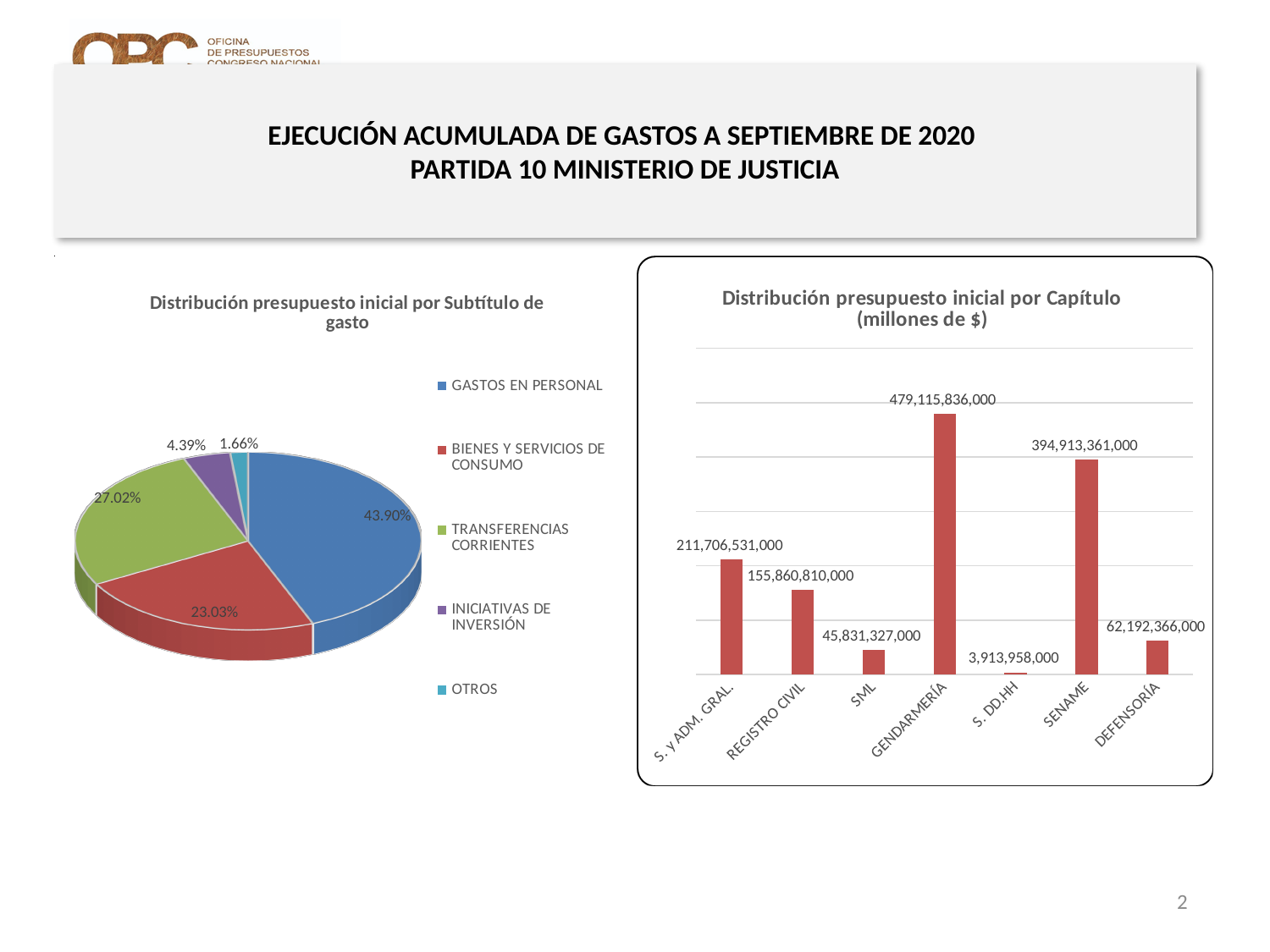
In the pie chart 'Distribución presupuesto inicial por Subtítulo de gasto', which category has the smallest slice? OTROS How many categories are shown in the chart 'Distribución presupuesto inicial por Capítulo (millones de $)'? 7 What kind of chart is 'Distribución presupuesto inicial por Capítulo (millones de $)'? Bar chart In the chart 'Distribución presupuesto inicial por Capítulo (millones de $)', what is the value for REGISTRO CIVIL? 155,860,810,000 In the chart 'Distribución presupuesto inicial por Capítulo (millones de $)', what is the difference between the values for GENDARMERÍA and SENAME? 84,202,475,000 In the chart 'Distribución presupuesto inicial por Capítulo (millones de $)', what is the value for GENDARMERÍA? 479,115,836,000 In the chart 'Distribución presupuesto inicial por Capítulo (millones de $)', which is larger, the value for SML or the value for DEFENSORÍA? DEFENSORÍA How many entries does the legend of the pie chart 'Distribución presupuesto inicial por Subtítulo de gasto' list? 5 In the chart 'Distribución presupuesto inicial por Capítulo (millones de $)', which category has the highest value? GENDARMERÍA In the pie chart 'Distribución presupuesto inicial por Subtítulo de gasto', what share does TRANSFERENCIAS CORRIENTES have? 27.02% In the chart 'Distribución presupuesto inicial por Capítulo (millones de $)', which category has the lowest value? S. DD.HH In the pie chart 'Distribución presupuesto inicial por Subtítulo de gasto', what share does GASTOS EN PERSONAL have? 43.90%